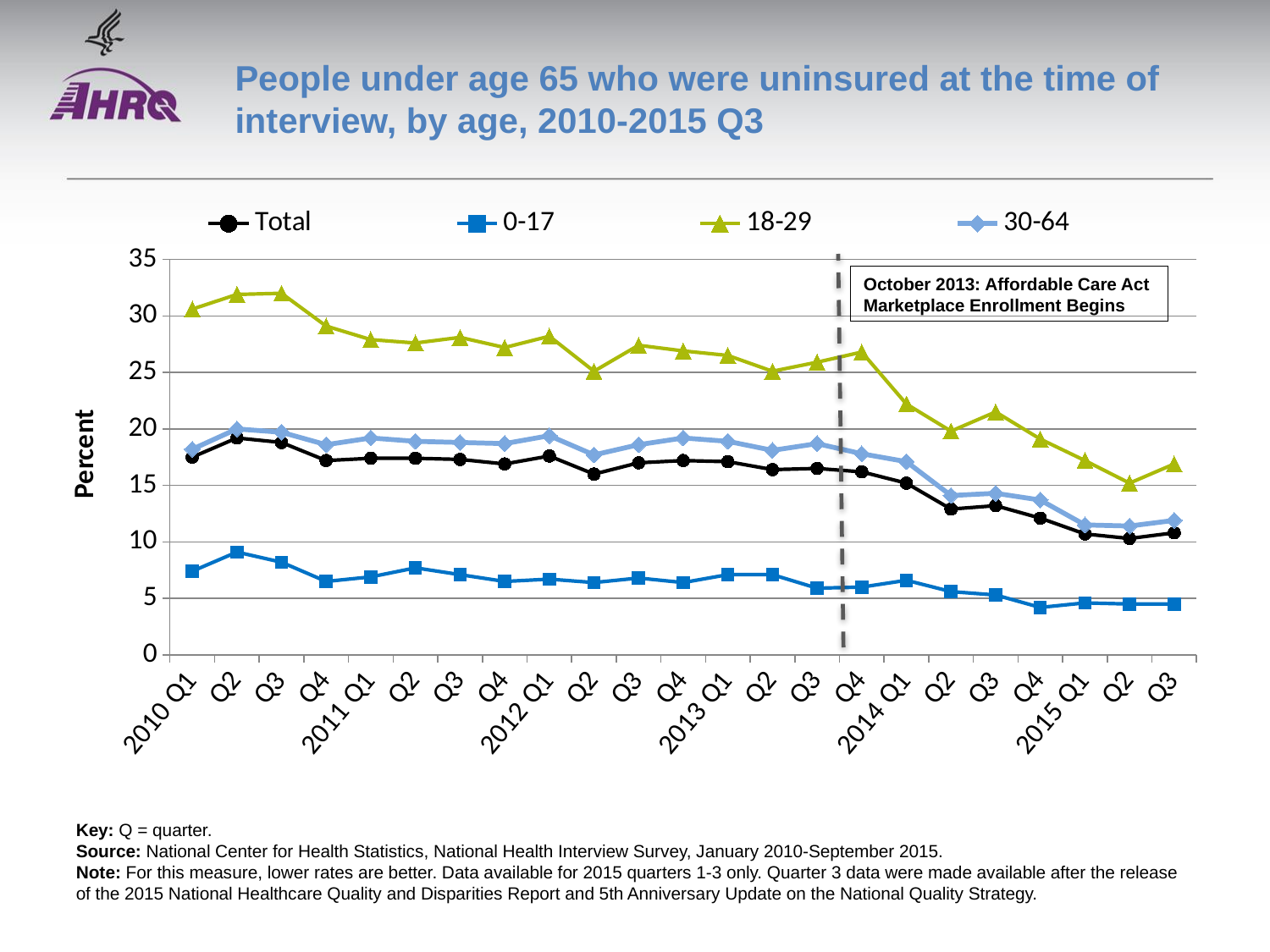
What event does the annotation next to the dashed vertical line describe? October 2013: Affordable Care Act Marketplace Enrollment Begins Does the 18-29 series rise or fall from 2013 Q4 to 2015 Q2? fall How many quarters are plotted along the x axis? 23 In which quarter does the 18-29 series reach its lowest value? 2015 Q2 Is the value for 30-64 in 2015 Q1 greater or less than 15? less Which age group has the lowest uninsured rate across all quarters? 0-17 Is the value for Total in 2015 Q3 greater or less than 15? less How many series does the legend list? 4 In 2014 Q1, which is larger: the value for 18-29 or the value for 30-64? 18-29 What kind of chart is shown on the slide? line chart Is the value for 18-29 in 2010 Q3 greater or less than 30? greater Which age group has the highest uninsured rate across all quarters? 18-29